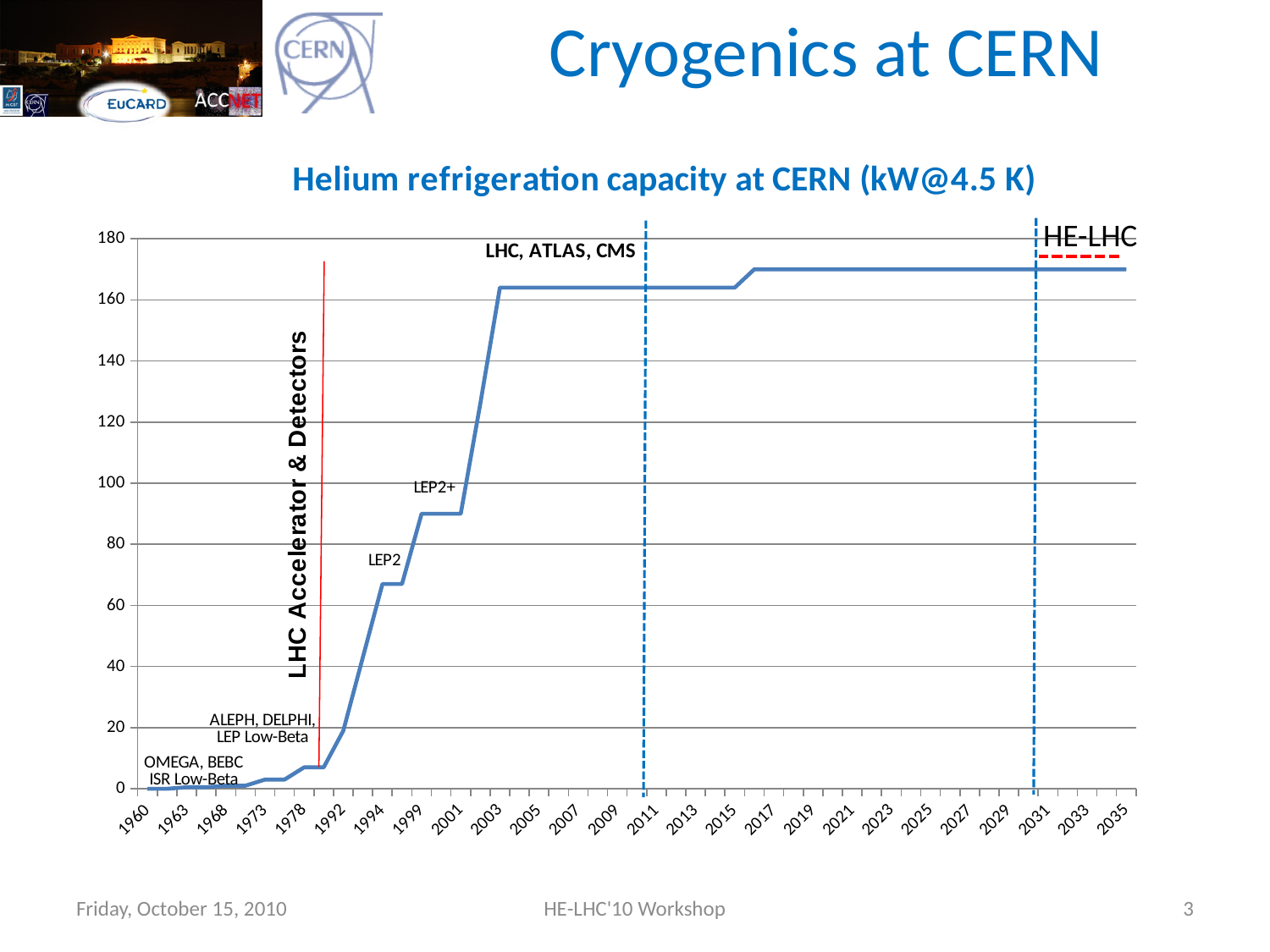
Is the value for 1992 greater or less than 40? less Is the value for 2005 greater or less than 140? greater Which year has the larger value, 2001 or 2003? 2003 Is the value for 1978 greater or less than 20? less Do the values generally rise or fall along the x axis from 1960 to 2035? rise What kind of chart is shown on the slide? line chart What is the title of the chart? Helium refrigeration capacity at CERN (kW@4.5 K) What label is written next to the red dashed line at the right end of the chart? HE-LHC Which year has the larger value, 1994 or 1999? 1999